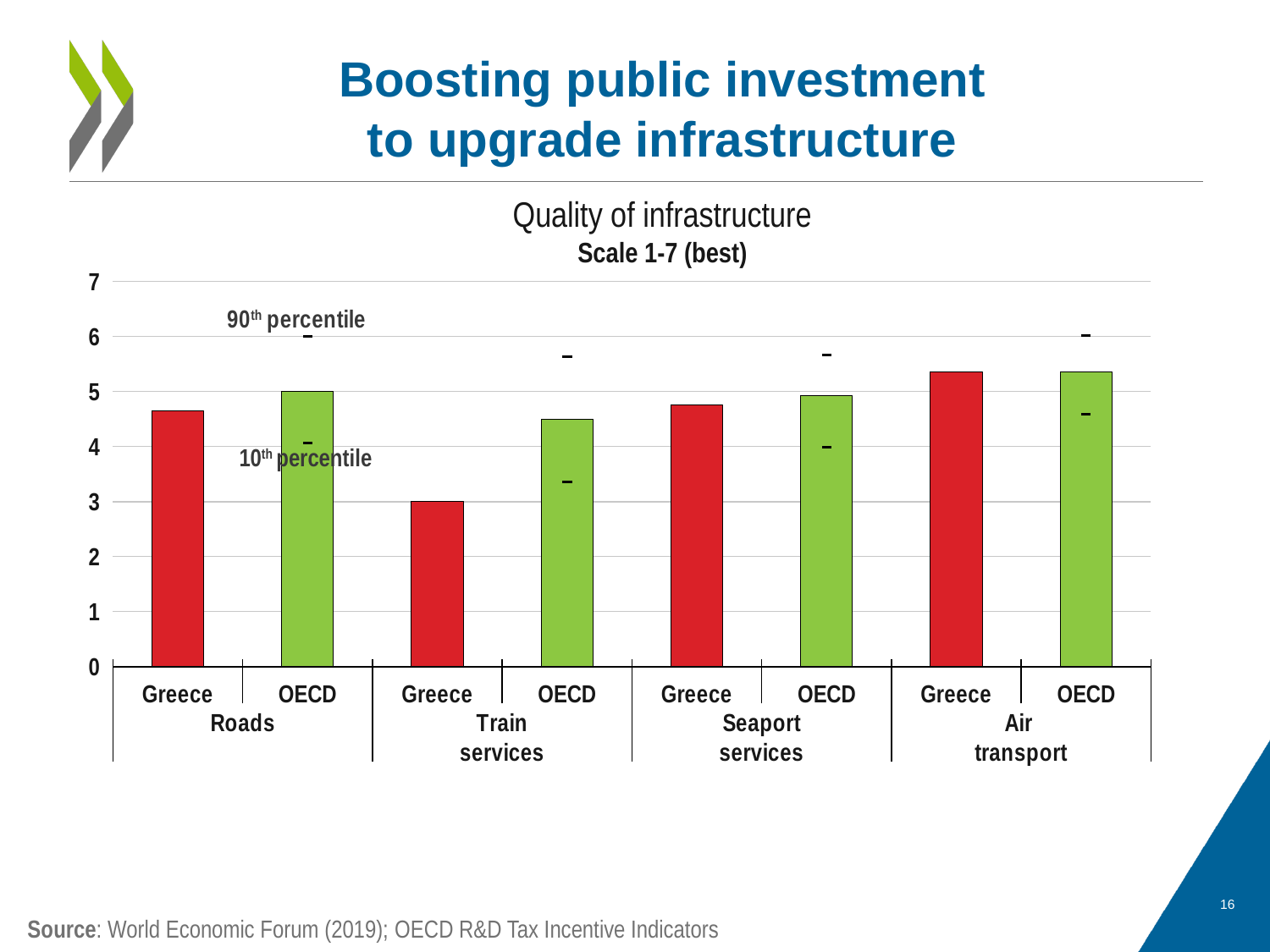
What kind of chart is shown on the slide? bar chart For Roads, which is larger: the value for Greece or the value for OECD? OECD How many bars are plotted in the chart? 8 Is the value for OECD in Train services greater or less than 5? less Is the value for Greece in Train services greater or less than 4? less Is the value for Greece in Air transport greater or less than 5? greater For Train services, which is larger: the value for Greece or the value for OECD? OECD Which bar in the chart is the lowest? Greece, Train services How many infrastructure categories are shown on the x axis of the chart? 4 Among the Greece bars, which infrastructure category has the highest value? Air transport What scale is used for the chart, according to its subtitle? Scale 1-7 (best)